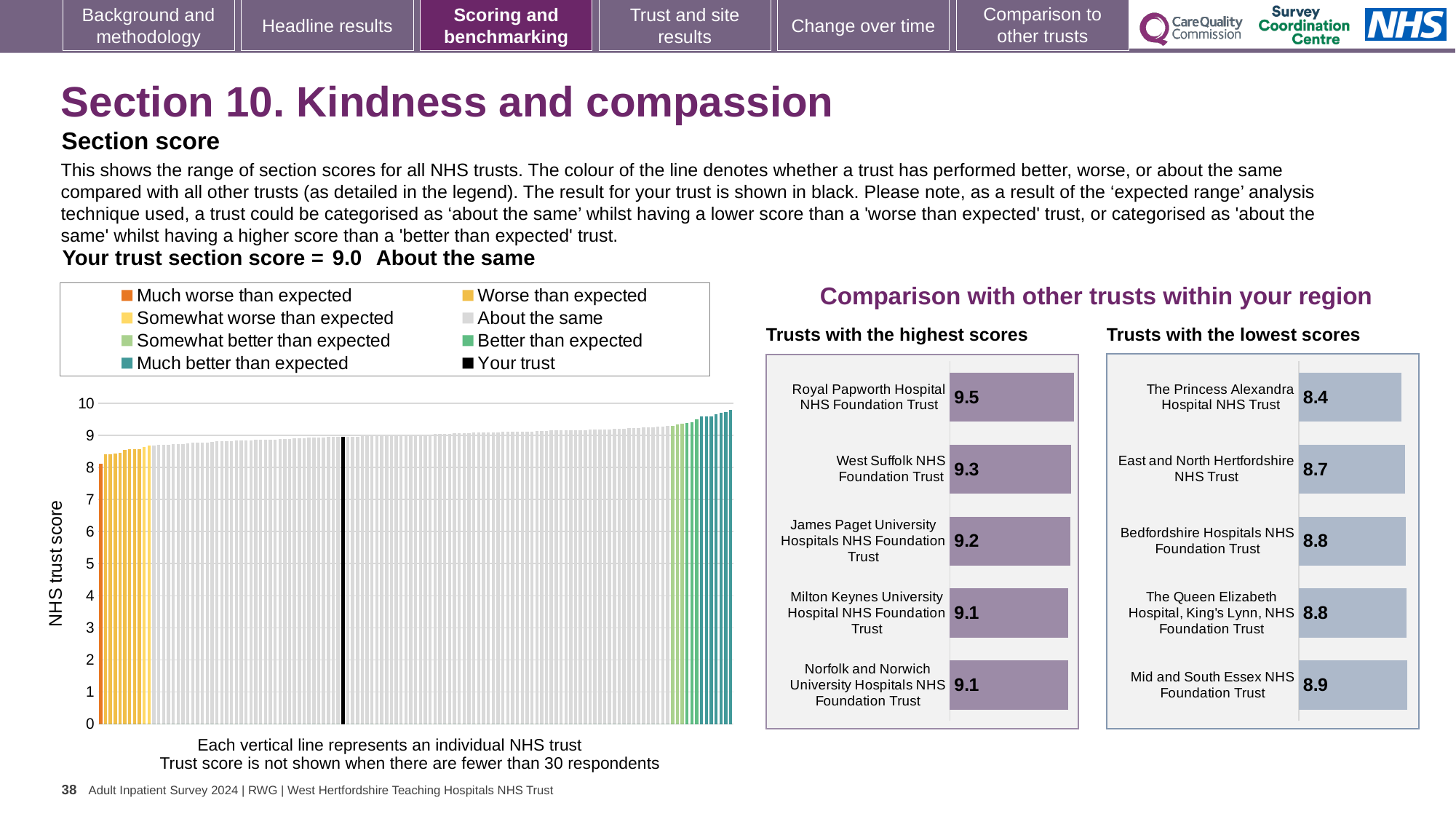
In the 'Trusts with the lowest scores' chart, what is the score for The Princess Alexandra Hospital NHS Trust? 8.4 In the 'Trusts with the highest scores' chart, what is the score for Royal Papworth Hospital NHS Foundation Trust? 9.5 In the 'Trusts with the lowest scores' chart, which trust has the lowest score? The Princess Alexandra Hospital NHS Trust In the 'Trusts with the highest scores' chart, what is the difference between the scores of Royal Papworth Hospital NHS Foundation Trust and West Suffolk NHS Foundation Trust? 0.2 In the 'Trusts with the highest scores' chart, which trust has the highest score? Royal Papworth Hospital NHS Foundation Trust In the 'Trusts with the highest scores' chart, which has the larger score: James Paget University Hospitals NHS Foundation Trust or Milton Keynes University Hospital NHS Foundation Trust? James Paget University Hospitals NHS Foundation Trust What kind of chart is the main 'NHS trust score' chart on the left? Bar chart In the main 'NHS trust score' chart on the left, what is the section score for your trust? 9.0 How many trusts are shown in the 'Trusts with the highest scores' chart? 5 How many entries does the legend of the main 'NHS trust score' chart on the left list? 8 In the 'Trusts with the lowest scores' chart, what is the score for East and North Hertfordshire NHS Trust? 8.7 In the 'Trusts with the lowest scores' chart, how much higher is the score of Mid and South Essex NHS Foundation Trust than that of The Princess Alexandra Hospital NHS Trust? 0.5